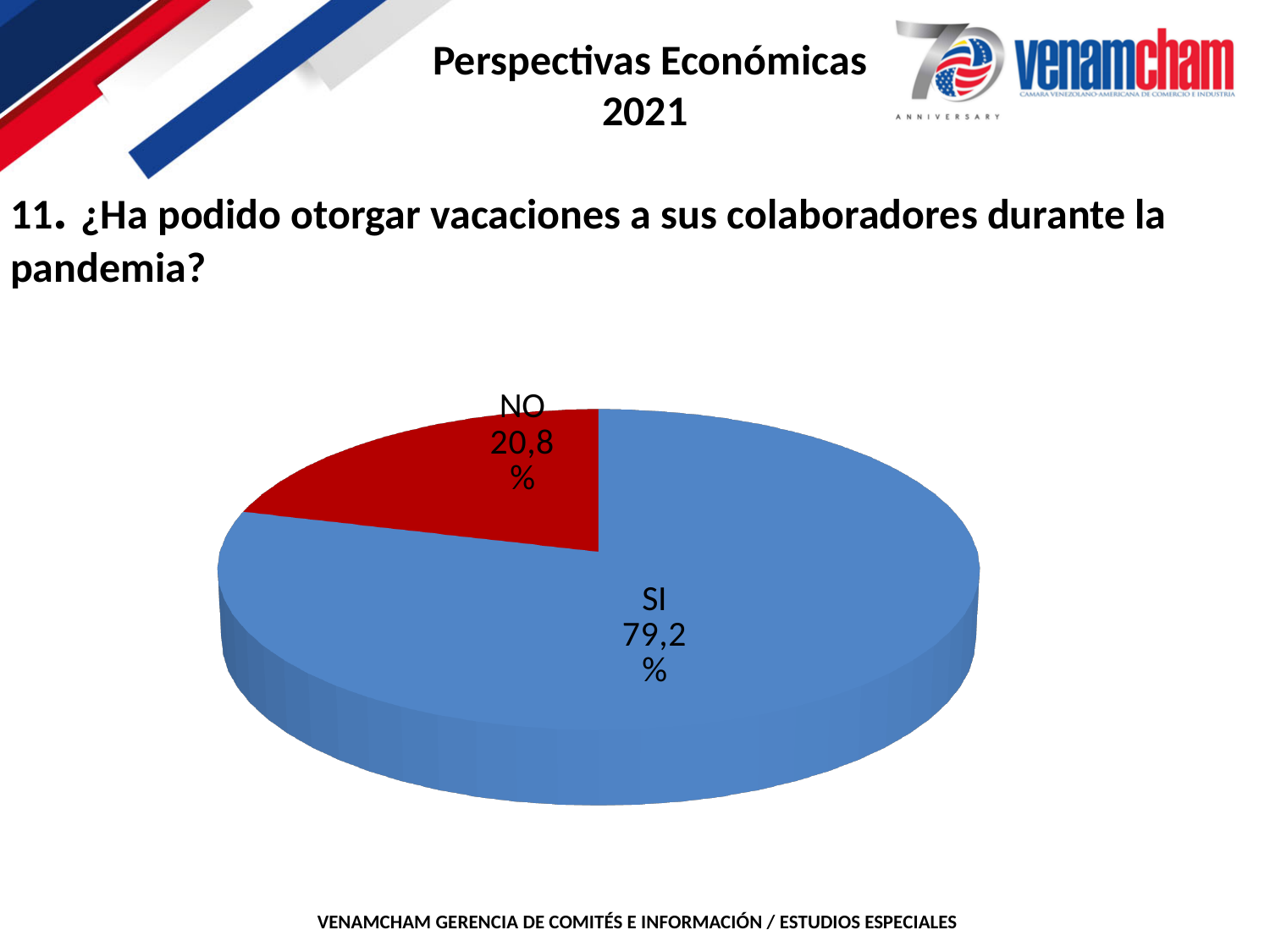
How many slices does the pie chart have? 2 Which slice is larger, SI or NO? SI What colour is the NO slice? Red What colour is the SI slice? Blue What is the difference in percentage points between the SI and NO slices? 58,4 What percentage of respondents answered NO? 20,8% What kind of chart is shown on the slide? Pie chart What percentage of respondents answered SI? 79,2% Which response has the smallest share of the pie? NO What share of the pie does the NO slice represent? 20,8% Which response has the largest share of the pie? SI